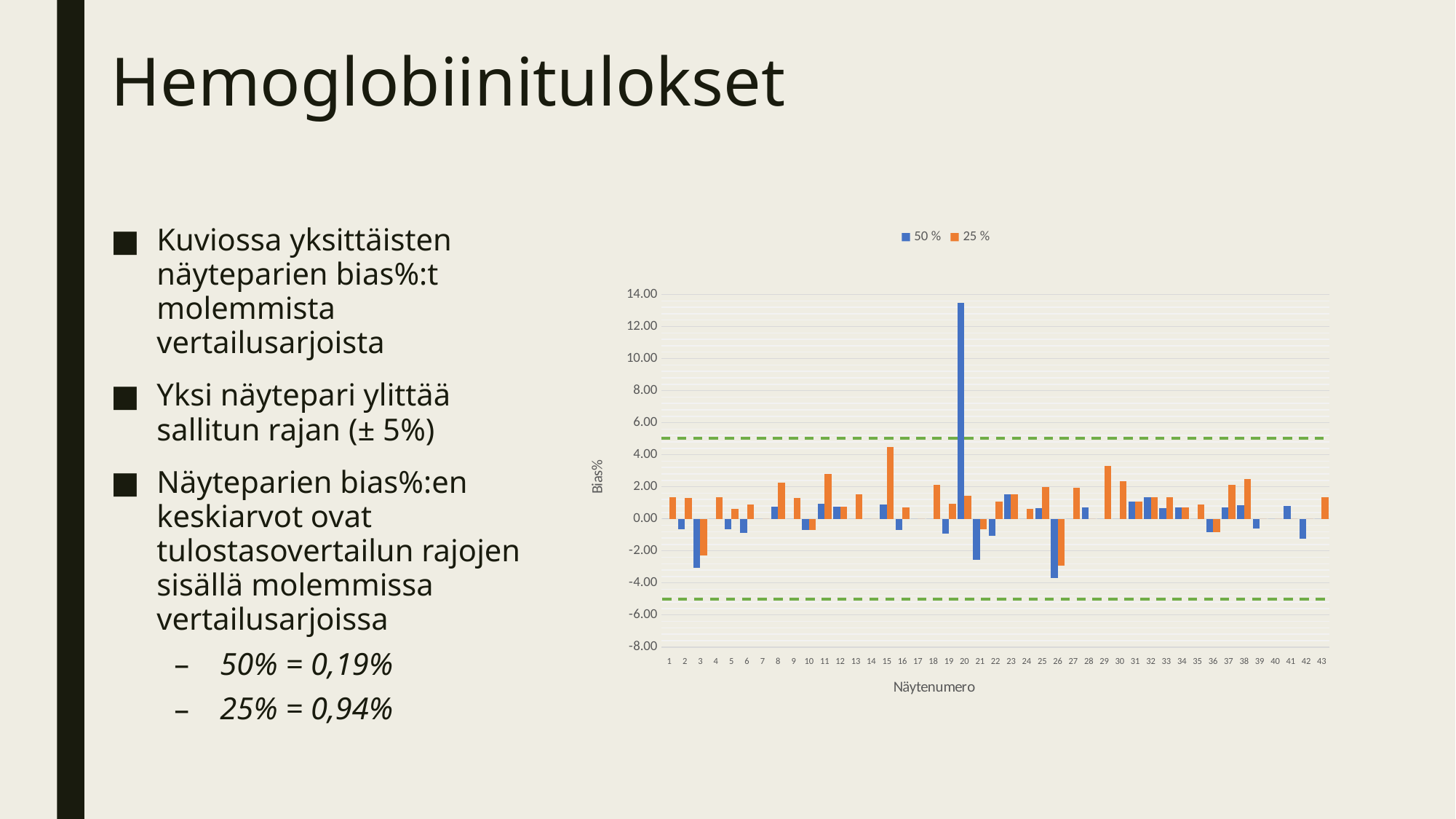
What is the title of the y axis of the chart? Bias% Is the 50 % value for sample 20 greater or less than 10.00? greater Which sample number has the highest value in the 50 % series? 20 How many series does the chart legend list? 2 How many sample numbers (Näytenumero) are shown on the x axis of the chart? 43 For sample 20, which series has the larger value, 50 % or 25 %? 50 % For sample 15, which series has the larger value, 50 % or 25 %? 25 % Is the 50 % value for sample 26 greater or less than -2.00? less What kind of chart is shown on the slide? bar chart What are the two series named in the chart legend? 50 % and 25 % Is the 25 % value for sample 15 greater or less than 2.00? greater